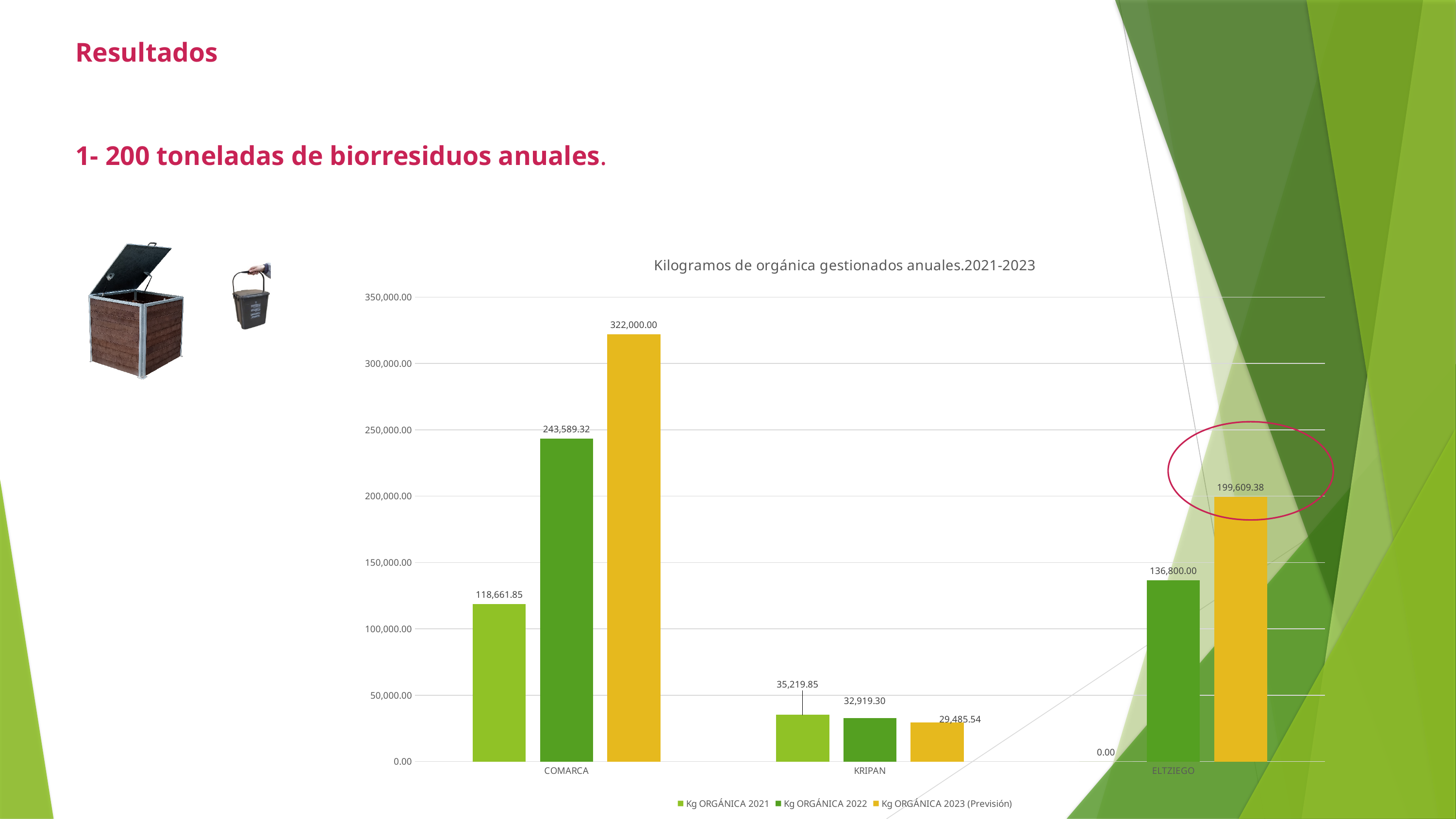
What type of chart is shown on the slide? bar chart What is the value for Kg ORGÁNICA 2022 for ELTZIEGO? 136,800.00 What is the value for Kg ORGÁNICA 2023 (Previsión) for COMARCA? 322,000.00 What is the difference between the Kg ORGÁNICA 2023 (Previsión) and Kg ORGÁNICA 2022 values for COMARCA? 78,410.68 Do the values for KRIPAN rise or fall from 2021 to 2023? fall Which category has the highest value for Kg ORGÁNICA 2022? COMARCA What is the value for Kg ORGÁNICA 2021 for KRIPAN? 35,219.85 Which category has the lowest value for Kg ORGÁNICA 2021? ELTZIEGO What is the title of the chart? Kilogramos de orgánica gestionados anuales.2021-2023 How many series does the legend list? 3 Which is larger for KRIPAN: the Kg ORGÁNICA 2021 value or the Kg ORGÁNICA 2023 (Previsión) value? Kg ORGÁNICA 2021 How many categories are shown on the x axis? 3